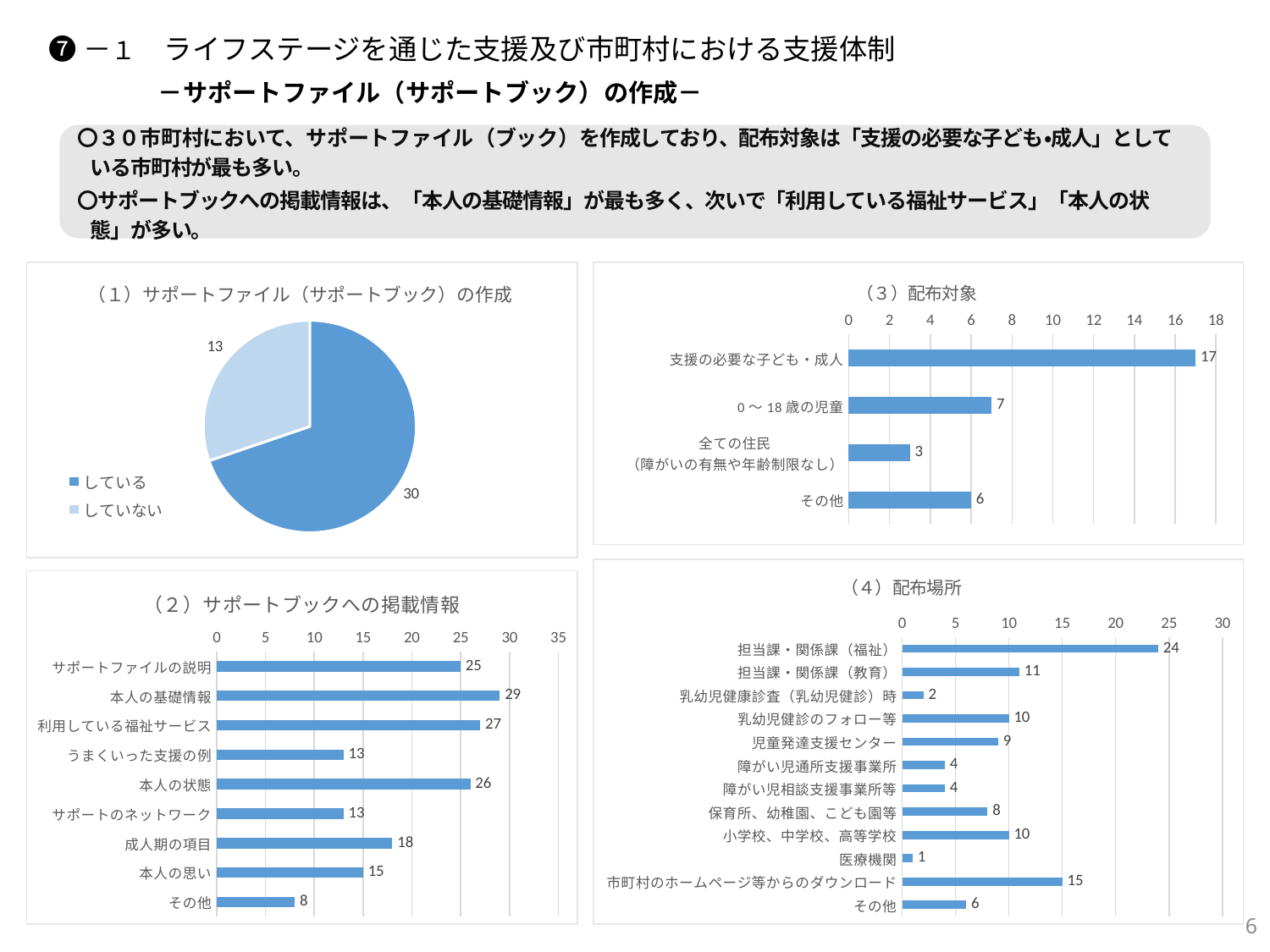
How many categories are shown in the chart titled （4）配布場所? 12 In the chart titled （1）サポートファイル（サポートブック）の作成, what is the value for している? 30 What kind of chart is （1）サポートファイル（サポートブック）の作成? pie chart In the chart titled （3）配布対象, which category has the lowest value? 全ての住民（障がいの有無や年齢制限なし） In the chart titled （2）サポートブックへの掲載情報, which category has the highest value? 本人の基礎情報 What kind of chart is （4）配布場所? bar chart How many categories are shown in the chart titled （2）サポートブックへの掲載情報? 9 In the chart titled （4）配布場所, what is the value for 市町村のホームページ等からのダウンロード? 15 In the chart titled （2）サポートブックへの掲載情報, what is the difference between 本人の基礎情報 and 本人の思い? 14 In the chart titled （2）サポートブックへの掲載情報, what is the value for 成人期の項目? 18 In the chart titled （3）配布対象, what is the value for 0～18歳の児童? 7 In the chart titled （4）配布場所, which is larger: 担当課・関係課（教育） or 児童発達支援センター? 担当課・関係課（教育）